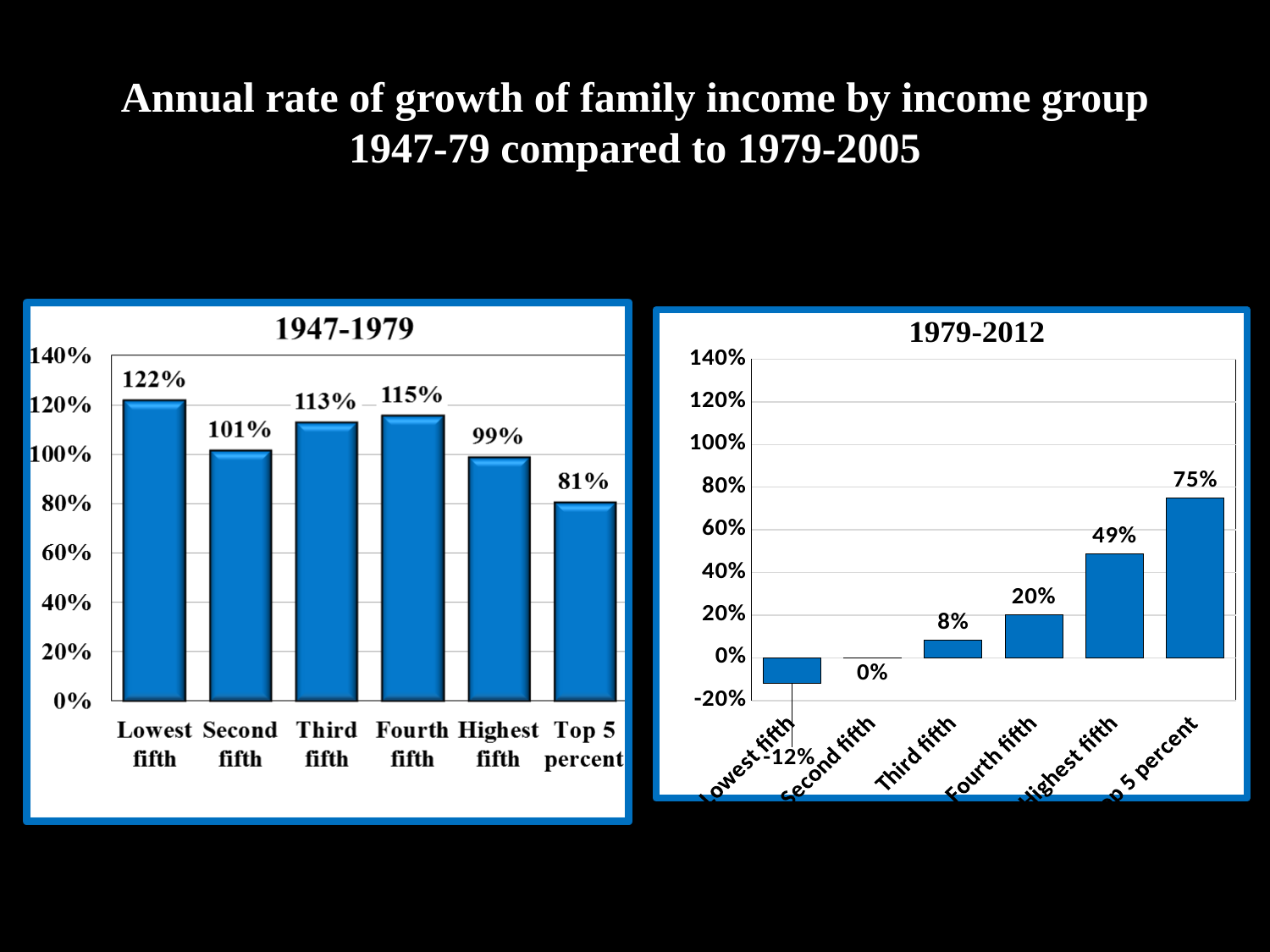
How many income groups are shown in the 1979-2012 chart? 6 In the 1947-1979 chart, which income group has the highest value? Lowest fifth In the 1979-2012 chart, what is the value for the Highest fifth? 49% In the 1947-1979 chart, what is the value for the Lowest fifth? 122% What kind of chart is the 1947-1979 chart? bar chart In the 1947-1979 chart, what is the value for the Top 5 percent? 81% In the 1979-2012 chart, do the values rise or fall from the Lowest fifth to the Top 5 percent? rise In the 1979-2012 chart, what is the difference between the Top 5 percent and the Fourth fifth? 55% In the 1947-1979 chart, which income group has the lowest value? Top 5 percent In the 1947-1979 chart, what is the difference between the Fourth fifth and the Third fifth? 2% In the 1979-2012 chart, which income group has the highest value? Top 5 percent In the 1979-2012 chart, what is the value for the Lowest fifth? -12%